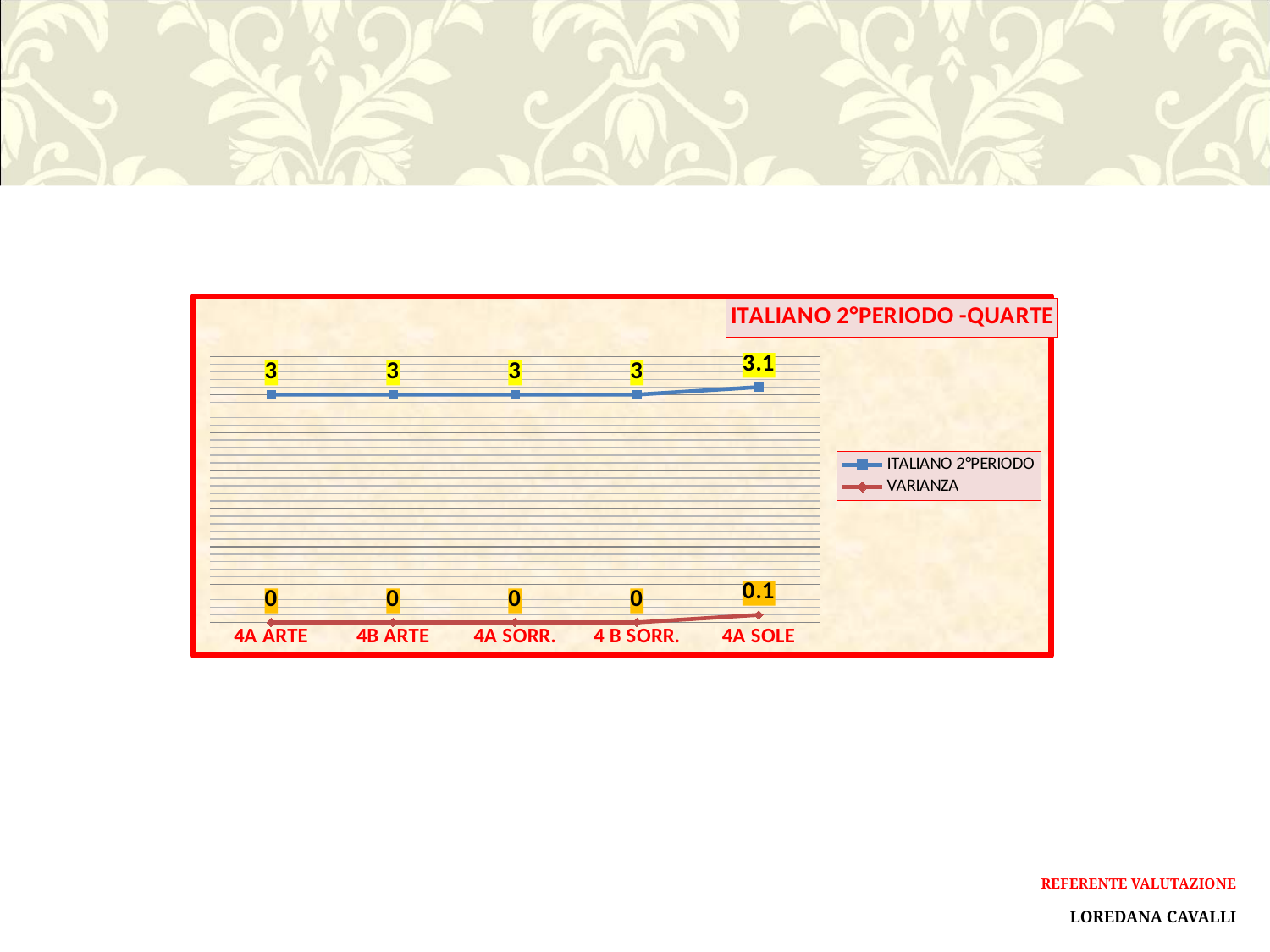
What is the ITALIANO 2°PERIODO value for 4A SOLE? 3.1 What is the title of the chart? ITALIANO 2°PERIODO -QUARTE What is the ITALIANO 2°PERIODO value for 4B ARTE? 3 How many series does the legend list? 2 What is the VARIANZA value for 4A SOLE? 0.1 What is the VARIANZA value for 4A SORR.? 0 Which category has the highest ITALIANO 2°PERIODO value? 4A SOLE Which is larger, the ITALIANO 2°PERIODO value for 4A SOLE or for 4A ARTE? 4A SOLE How many categories are shown on the x axis? 5 Which category has the highest VARIANZA value? 4A SOLE What kind of chart is shown on the slide? Line chart What is the difference between the ITALIANO 2°PERIODO values for 4A SOLE and 4 B SORR.? 0.1